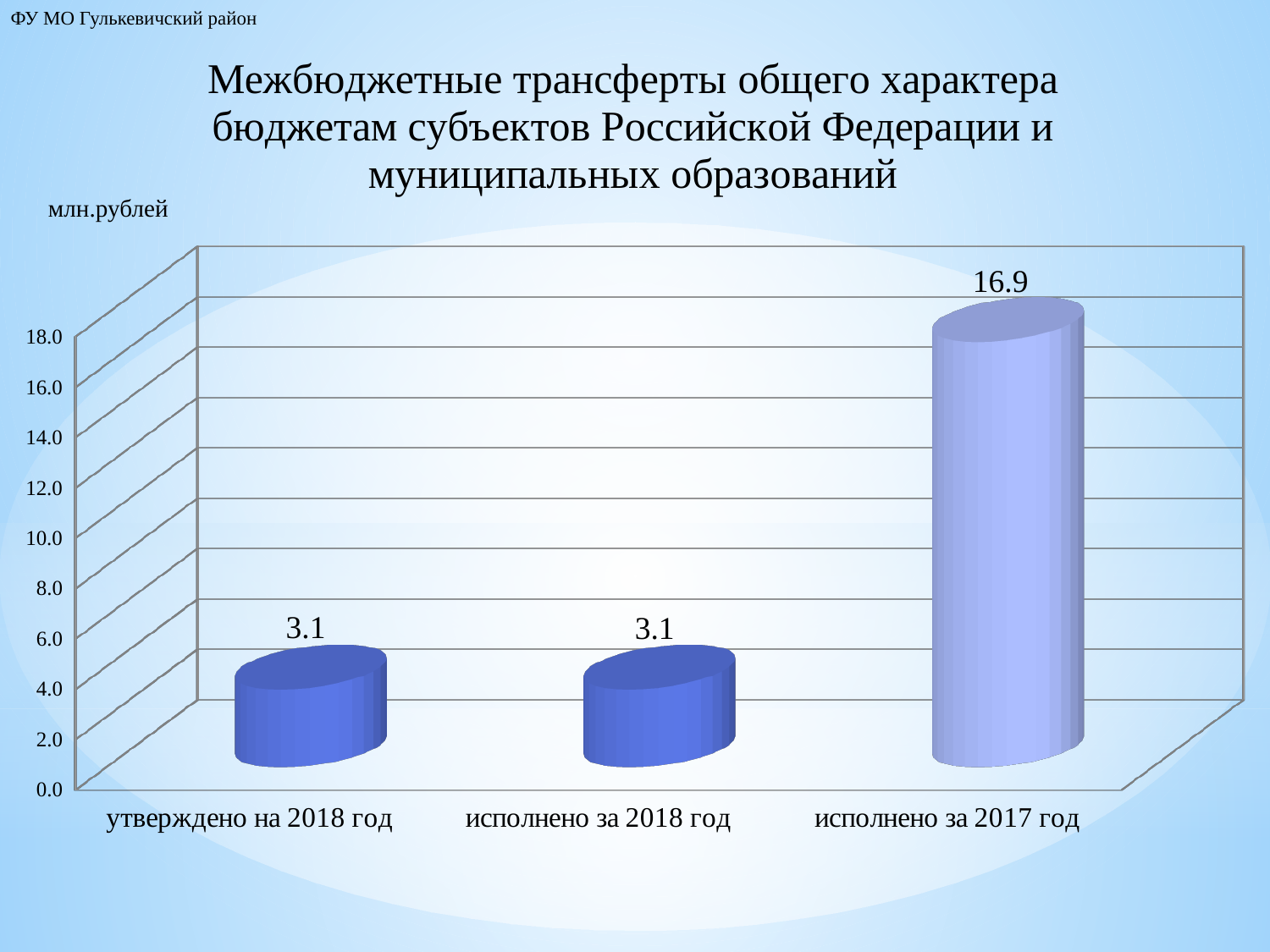
Which is larger: the value for 'исполнено за 2017 год' or the value for 'утверждено на 2018 год'? исполнено за 2017 год Is the value for 'исполнено за 2017 год' greater or less than 14.0? greater What unit of measurement is indicated above the chart? млн.рублей What is the value for 'утверждено на 2018 год'? 3.1 Which category has the highest value? исполнено за 2017 год What kind of chart is shown on the slide? bar chart What is the value for 'исполнено за 2017 год'? 16.9 What is the maximum value shown on the vertical axis? 18.0 What is the value for 'исполнено за 2018 год'? 3.1 Is the value for 'утверждено на 2018 год' greater or less than 6.0? less How many categories are shown on the x axis? 3 What is the difference between the value for 'исполнено за 2017 год' and the value for 'исполнено за 2018 год'? 13.8